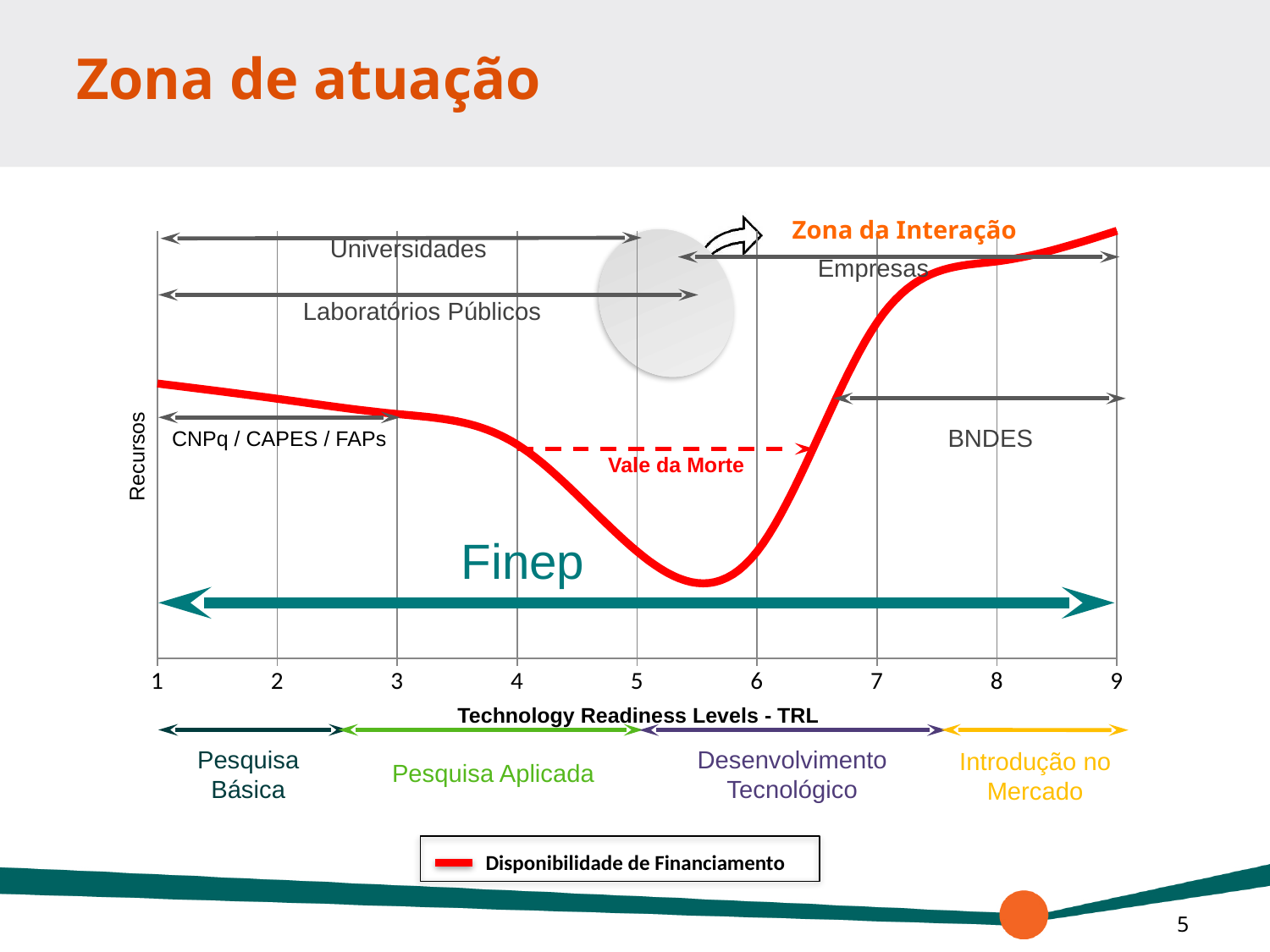
What is the label of the x axis of the chart? Technology Readiness Levels - TRL Is the red curve higher at TRL 5 or at TRL 7? TRL 7 How many series does the legend list? 1 How many TRL levels are marked along the x axis? 9 Does the red curve rise or fall along the x axis between TRL 6 and TRL 9? rise Which of the four x-axis phases contains the lowest point of the red curve? Desenvolvimento Tecnológico Is the red curve higher at TRL 1 or at TRL 9? TRL 9 What is the title of the slide containing the chart? Zona de atuação What kind of chart is shown on the slide? line chart Which labelled region of the chart marks the lowest part of the red curve? Vale da Morte Is the red curve higher at TRL 3 or at TRL 6? TRL 3 Does the red curve rise or fall along the x axis between TRL 1 and TRL 5? fall